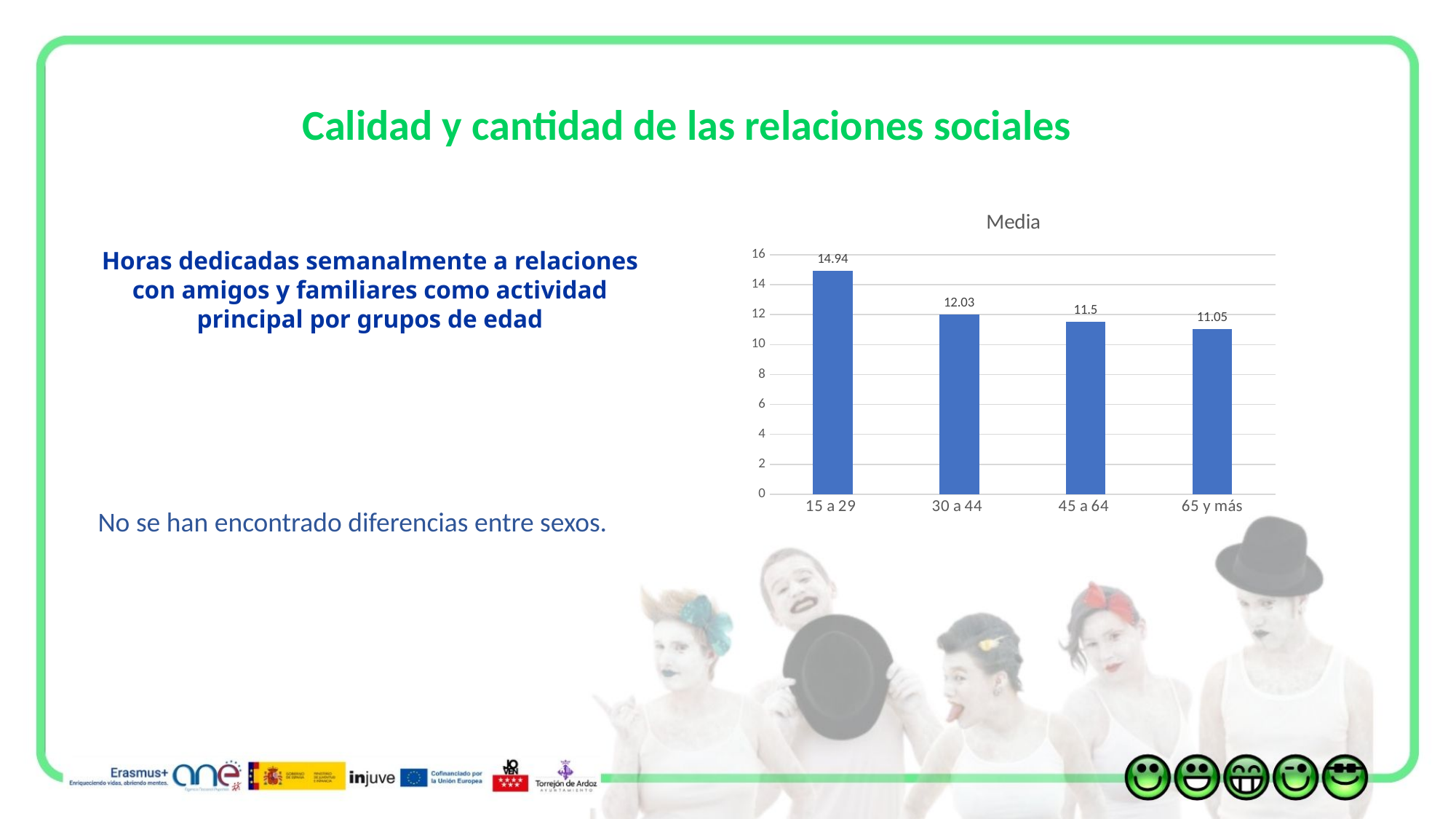
How many age groups are shown in the chart? 4 What is the value for the 65 y más age group? 11.05 Which age group has the highest value? 15 a 29 Which age group has the lowest value? 65 y más What is the value for the 30 a 44 age group? 12.03 What is the difference between the values for 30 a 44 and 45 a 64? 0.53 What is the difference between the values for 15 a 29 and 65 y más? 3.89 What is the value for the 45 a 64 age group? 11.5 What is the value for the 15 a 29 age group? 14.94 Do the values rise or fall from the youngest to the oldest age group? Fall What kind of chart is shown on the slide? Bar chart Which is larger, the value for 15 a 29 or the value for 30 a 44? 15 a 29